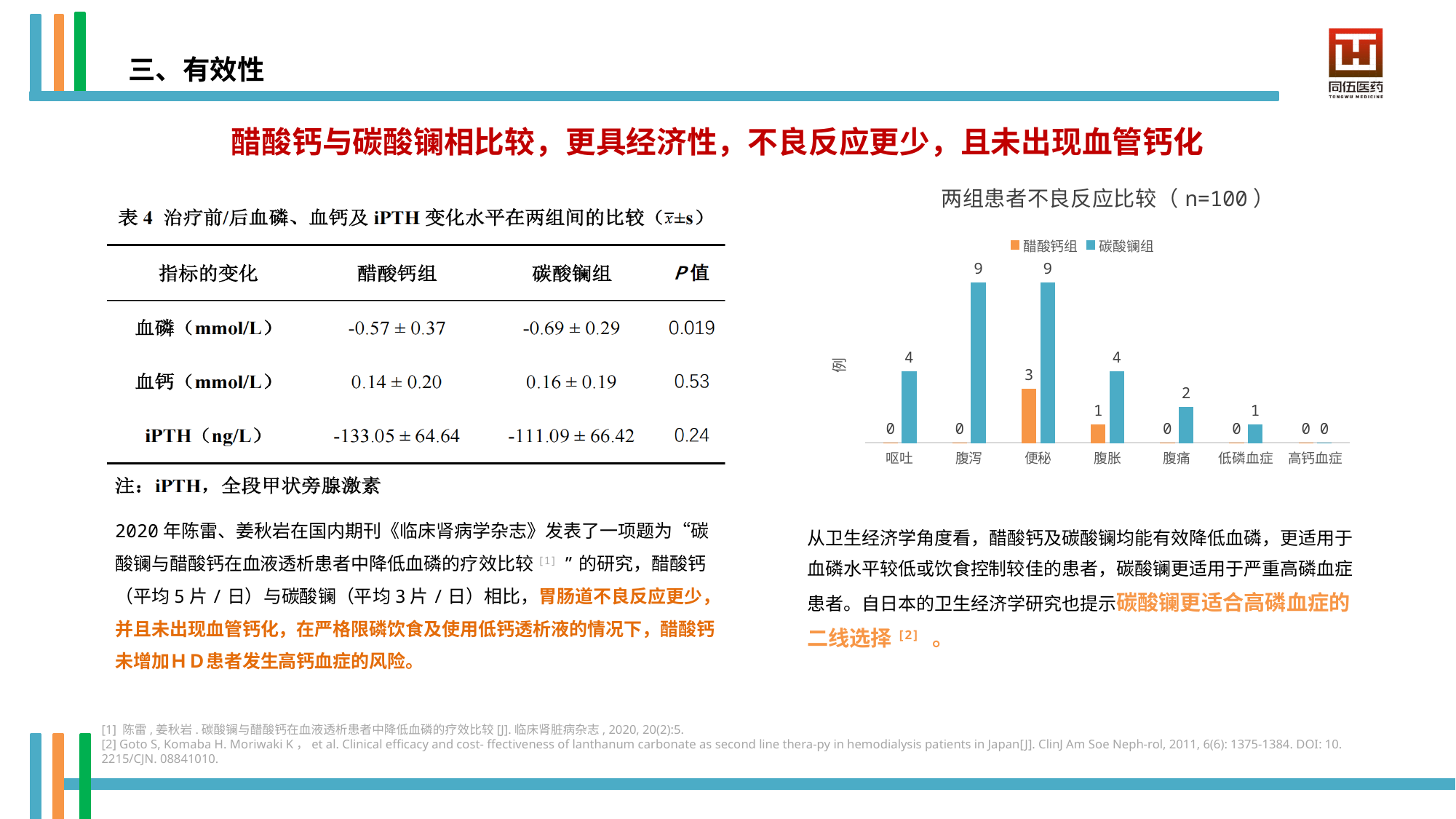
What is the value for 醋酸钙组 in the 腹胀 category? 1 What is the value for 碳酸镧组 in the 腹泻 category? 9 Which category has the highest value for 醋酸钙组? 便秘 What is the value for 碳酸镧组 in the 呕吐 category? 4 What is the difference between 碳酸镧组 and 醋酸钙组 in the 便秘 category? 6 How many categories of adverse reactions are shown on the x axis of the chart? 7 What is the value for 醋酸钙组 in the 便秘 category? 3 How many series does the legend of the chart list? 2 What type of chart is shown on the slide? bar chart Which is larger in the 腹胀 category, 醋酸钙组 or 碳酸镧组? 碳酸镧组 What is the value for 碳酸镧组 in the 高钙血症 category? 0 What is the title of the chart? 两组患者不良反应比较（n=100）